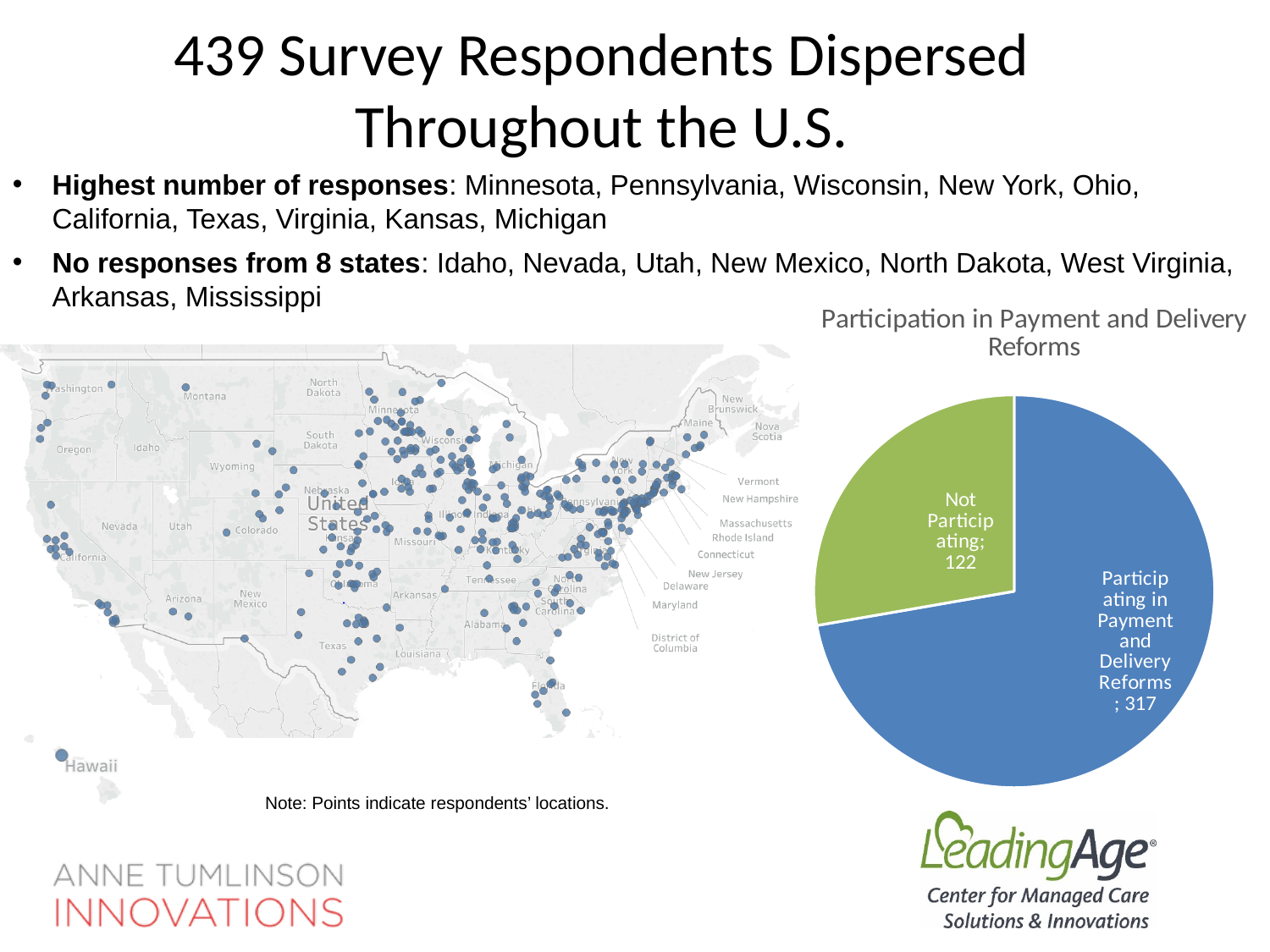
In the pie chart on the right of the slide, which slice is the smallest? Not Participating What is the title of the pie chart on the right of the slide? Participation in Payment and Delivery Reforms In the pie chart titled 'Participation in Payment and Delivery Reforms', what is the difference between the 'Participating in Payment and Delivery Reforms' value and the 'Not Participating' value? 195 In the pie chart on the right of the slide, what colour is the 'Not Participating' slice? Green In the pie chart on the right of the slide, which is larger: 'Not Participating' or 'Participating in Payment and Delivery Reforms'? Participating in Payment and Delivery Reforms In the pie chart on the right of the slide, what is the total of the two slices? 439 In the pie chart titled 'Participation in Payment and Delivery Reforms', what is the value for 'Participating in Payment and Delivery Reforms'? 317 In the pie chart titled 'Participation in Payment and Delivery Reforms', what is the value for 'Not Participating'? 122 In the pie chart on the right of the slide, which slice is the largest? Participating in Payment and Delivery Reforms How many slices does the pie chart titled 'Participation in Payment and Delivery Reforms' have? 2 What kind of chart is the chart titled 'Participation in Payment and Delivery Reforms'? Pie chart